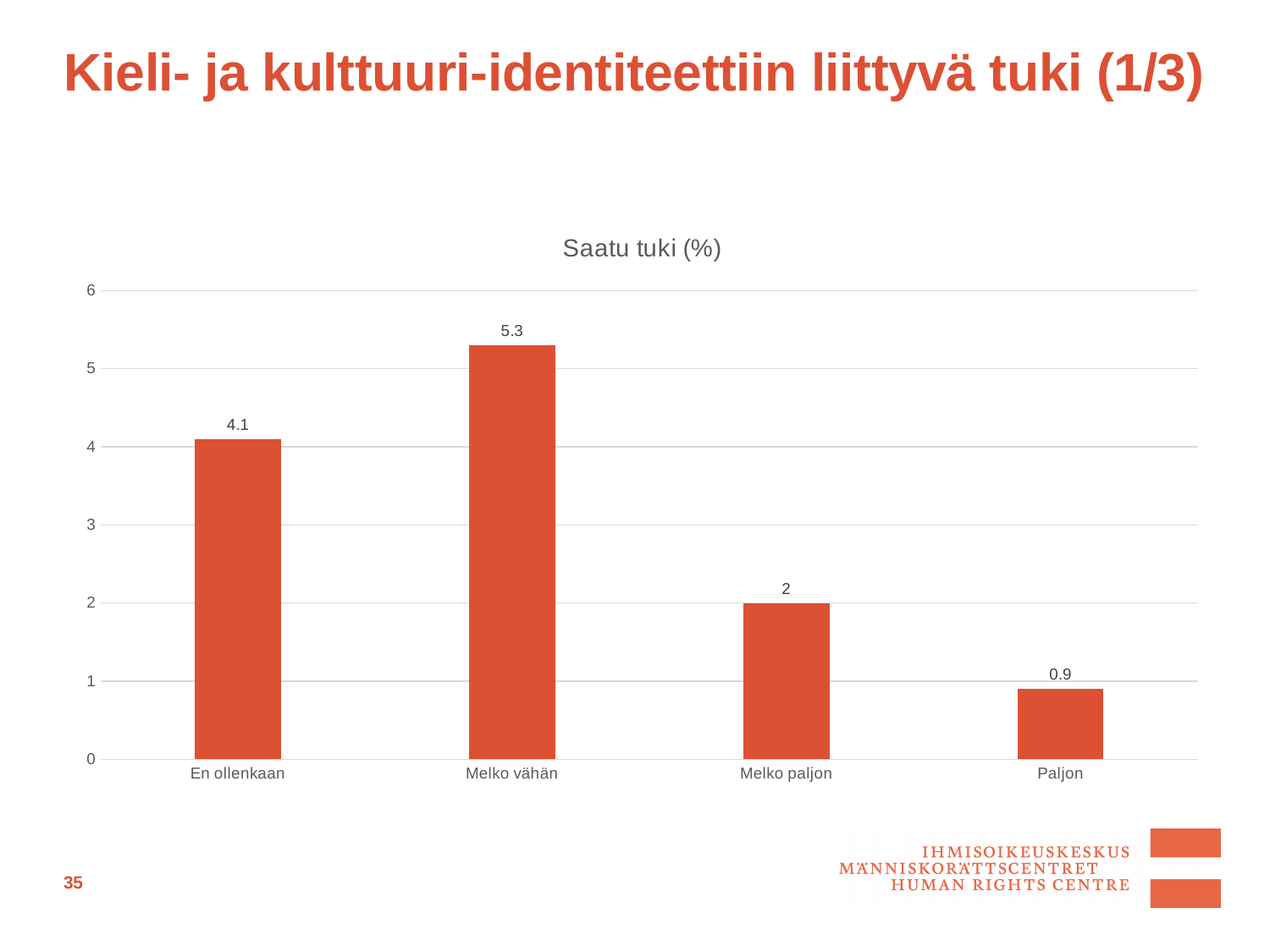
Which category has the lowest value? Paljon What kind of chart is shown on the slide? bar chart Which is larger, the value for En ollenkaan or the value for Melko paljon? En ollenkaan Which category has the highest value? Melko vähän What is the value for Paljon? 0.9 What is the value for En ollenkaan? 4.1 Is the value for Melko vähän greater or less than 5? greater What is the title of the chart? Saatu tuki (%) How many categories are shown on the x axis? 4 What is the difference between the values for Melko vähän and En ollenkaan? 1.2 What is the value for Melko vähän? 5.3 What is the difference between the values for Melko paljon and Paljon? 1.1